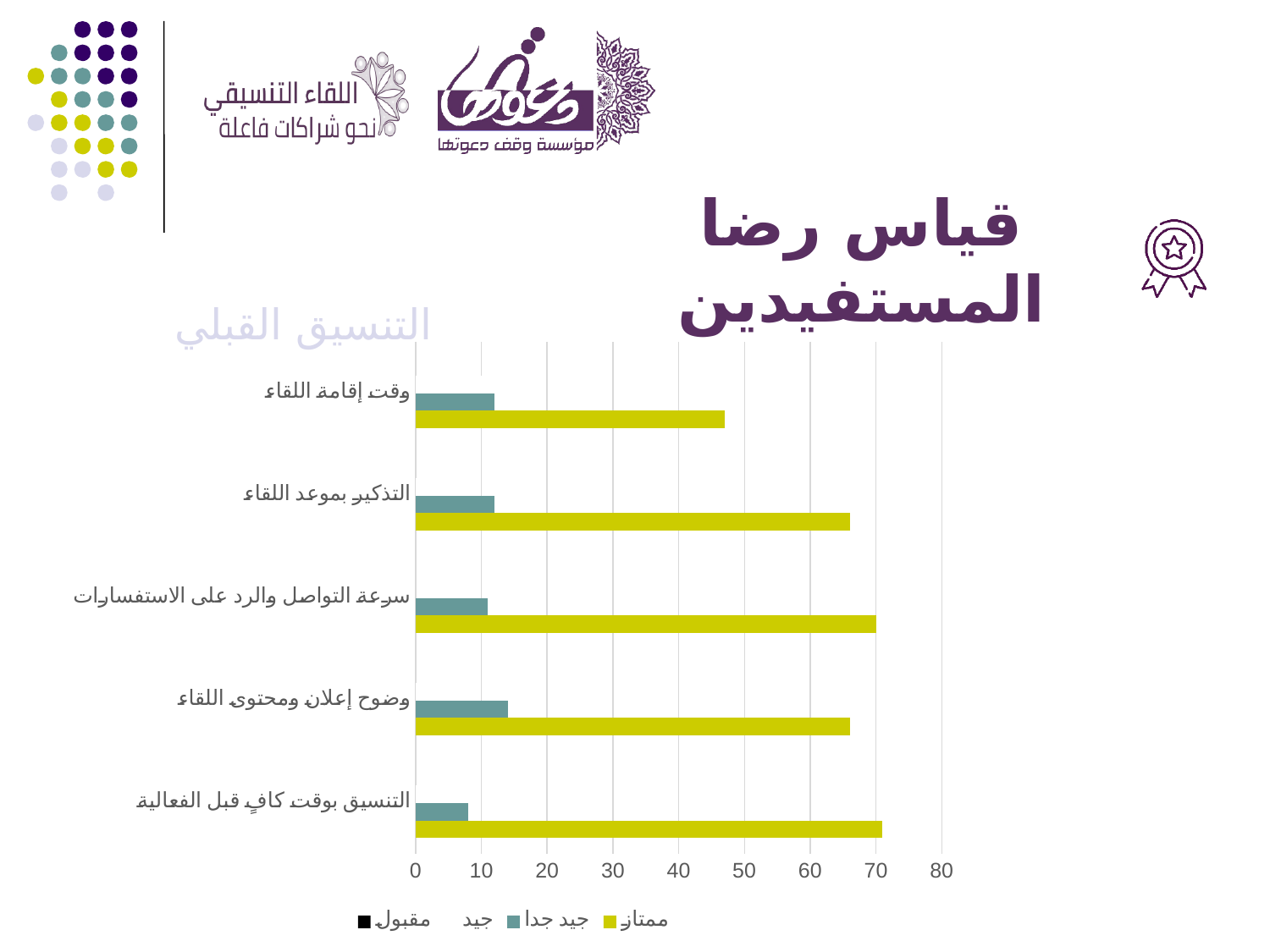
Which colour represents the ممتاز series in the chart? Yellow Is the جيد جدا value for التنسيق بوقت كافٍ قبل الفعالية greater or less than 10? less What kind of chart is shown on the slide? Bar chart For وضوح إعلان ومحتوى اللقاء, which series has the larger value, ممتاز or جيد جدا? ممتاز Is the ممتاز value for سرعة التواصل والرد على الاستفسارات greater or less than 60? greater How many series does the chart legend list? 4 Which category has the lowest value for the ممتاز series? وقت إقامة اللقاء Is the ممتاز value for التذكير بموعد اللقاء greater or less than 60? greater How many categories are shown on the chart? 5 Which category has the lowest value for the جيد جدا series? التنسيق بوقت كافٍ قبل الفعالية What is the title of the chart? التنسيق القبلي